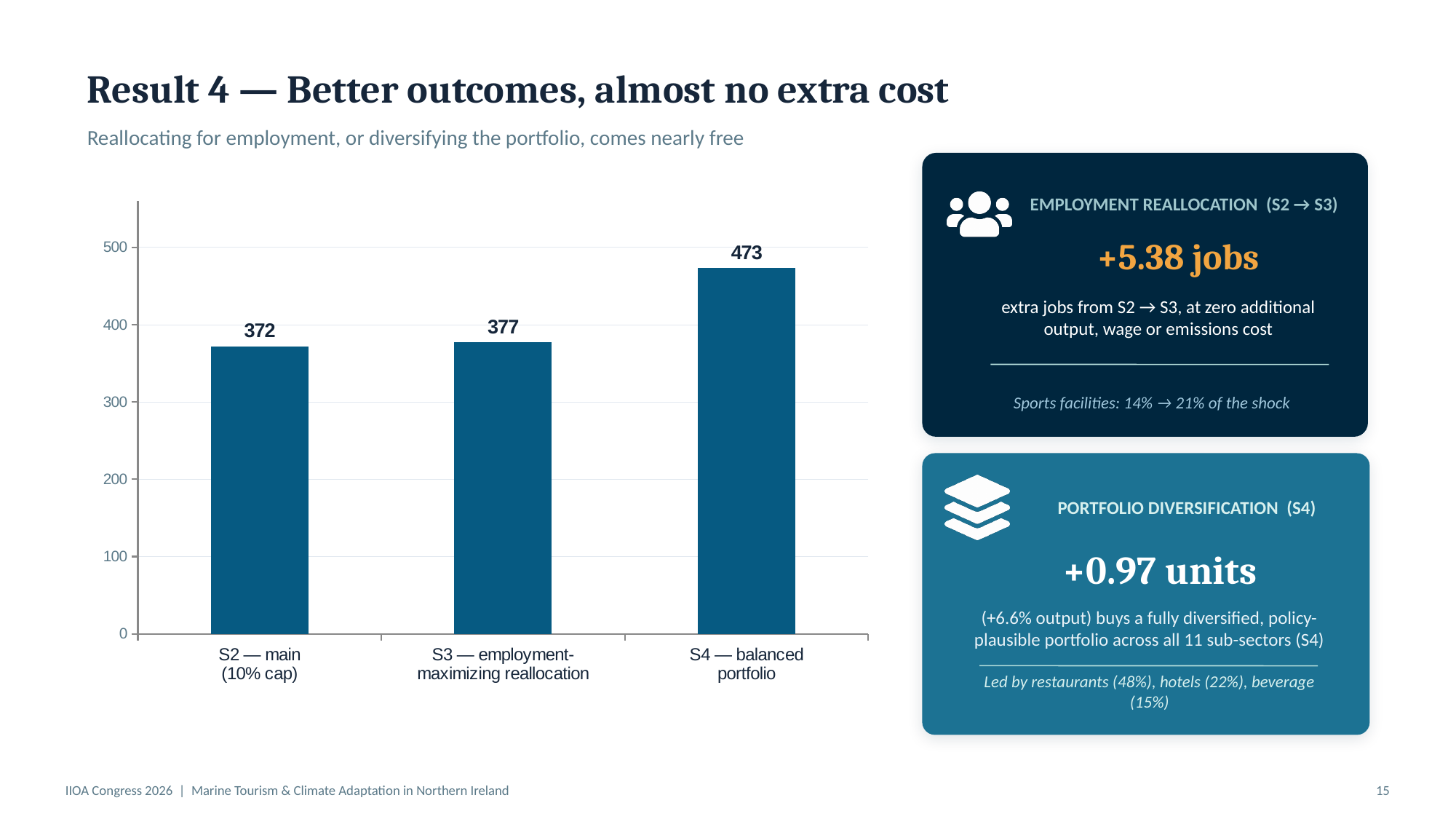
What is the value for S3 — employment-maximizing reallocation? 377 Is the value for S4 — balanced portfolio greater or less than 400? greater What is the value for S4 — balanced portfolio? 473 Do the values rise or fall from S2 to S4 along the x axis? rise What is the difference between the values for S3 — employment-maximizing reallocation and S2 — main (10% cap)? 5 What is the difference between the values for S4 — balanced portfolio and S2 — main (10% cap)? 101 Which is larger, the value for S4 — balanced portfolio or the value for S3 — employment-maximizing reallocation? S4 — balanced portfolio What is the value for S2 — main (10% cap)? 372 Which category has the highest value? S4 — balanced portfolio Which category has the lowest value? S2 — main (10% cap) How many categories are shown on the chart? 3 What kind of chart is shown on the slide? bar chart